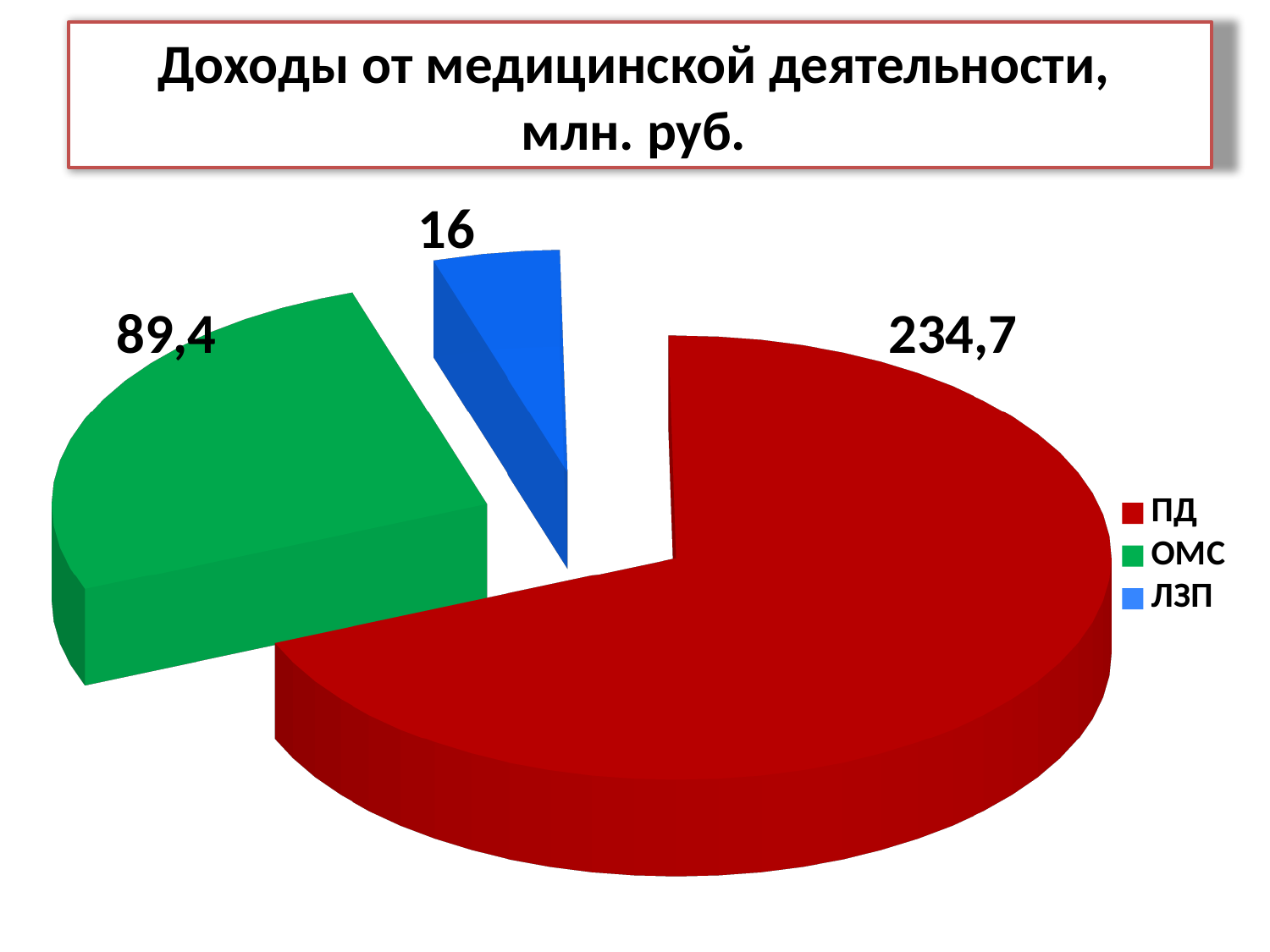
What is the value for ЛЗП? 16 What is the value for ПД? 234,7 Which category has the largest slice? ПД What is the difference between the values for ОМС and ЛЗП? 73,4 What type of chart is shown on the slide? Pie chart What is the title of the chart? Доходы от медицинской деятельности, млн. руб. Which category has the smallest slice? ЛЗП How many categories does the pie chart have? 3 What is the value for ОМС? 89,4 What is the difference between the values for ПД and ОМС? 145,3 What is the total of all slices in the pie chart? 340,1 Which is larger, the value for ОМС or the value for ЛЗП? ОМС